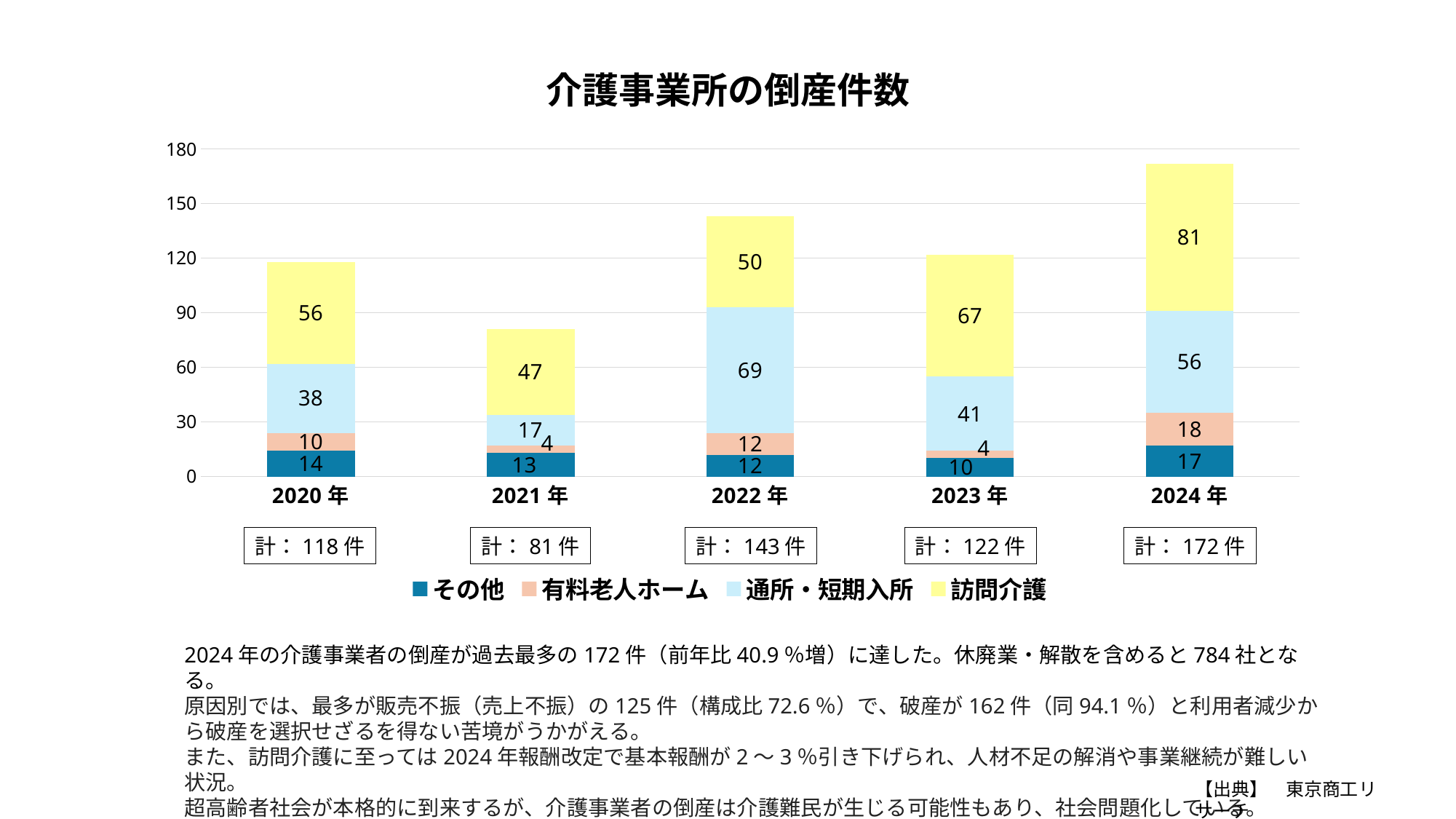
Which year has the lowest total number of bankruptcies? 2021年 Which is larger, the 通所・短期入所 value in 2020年 or in 2023年? 2023年 What is the title of the chart? 介護事業所の倒産件数 What is the total shown for 2023年? 122件 What is the value for 訪問介護 in 2024年? 81 How many series does the legend list? 4 How many years are shown on the x axis? 5 What is the value for 有料老人ホーム in 2021年? 4 What kind of chart is shown? Stacked bar chart What is the difference between the 訪問介護 values for 2024年 and 2023年? 14 Which year has the highest total number of bankruptcies? 2024年 What is the value for 通所・短期入所 in 2022年? 69